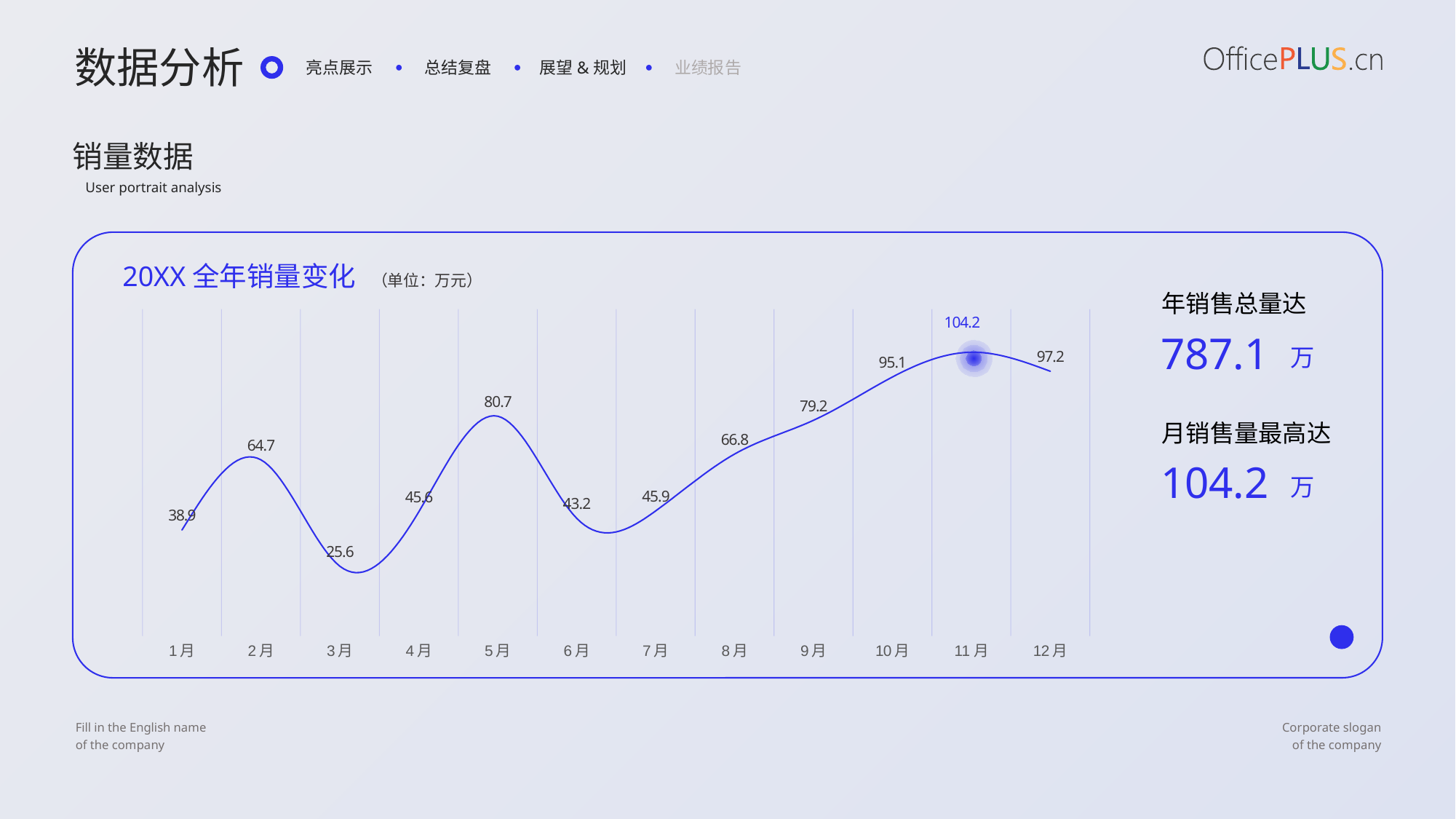
Which month has the lowest value in the chart? 3月 What is the value for 9月 in the chart? 79.2 What kind of chart is shown on the slide? line chart What is the value for 5月 in the chart? 80.7 Do the values rise or fall from 6月 to 11月? rise Which month has the highest value in the chart? 11月 What is the title of the chart? 20XX 全年销量变化 What is the difference between the values for 11月 and 12月? 7.0 How many months are plotted in the chart? 12 What is the difference between the values for 2月 and 3月? 39.1 Which is larger, the value for 4月 or the value for 6月? 4月 What is the value for 1月 in the chart? 38.9